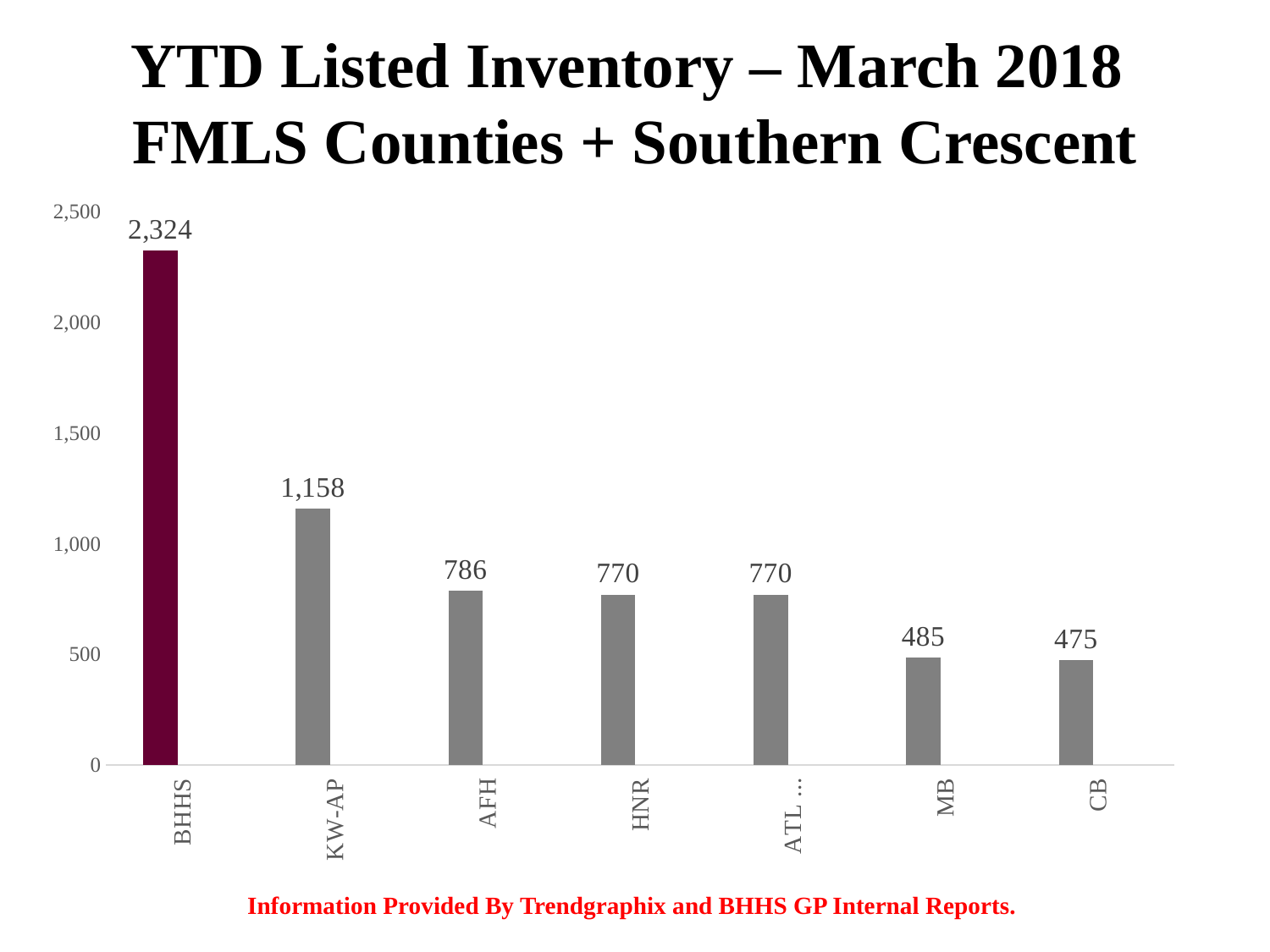
What kind of chart is shown on the slide? bar chart Which bar is coloured differently from the others? BHHS Which category has the lowest value? CB What is the value shown for MB? 485 What is the difference between the values for BHHS and KW-AP? 1,166 Which is larger, the value for MB or the value for CB? MB What is the difference between the values for AFH and HNR? 16 Is the value for AFH greater or less than 1,000? less Which category has the highest value? BHHS What is the YTD listed inventory value for BHHS? 2,324 What is the value shown for KW-AP? 1,158 How many categories are shown on the x axis? 7